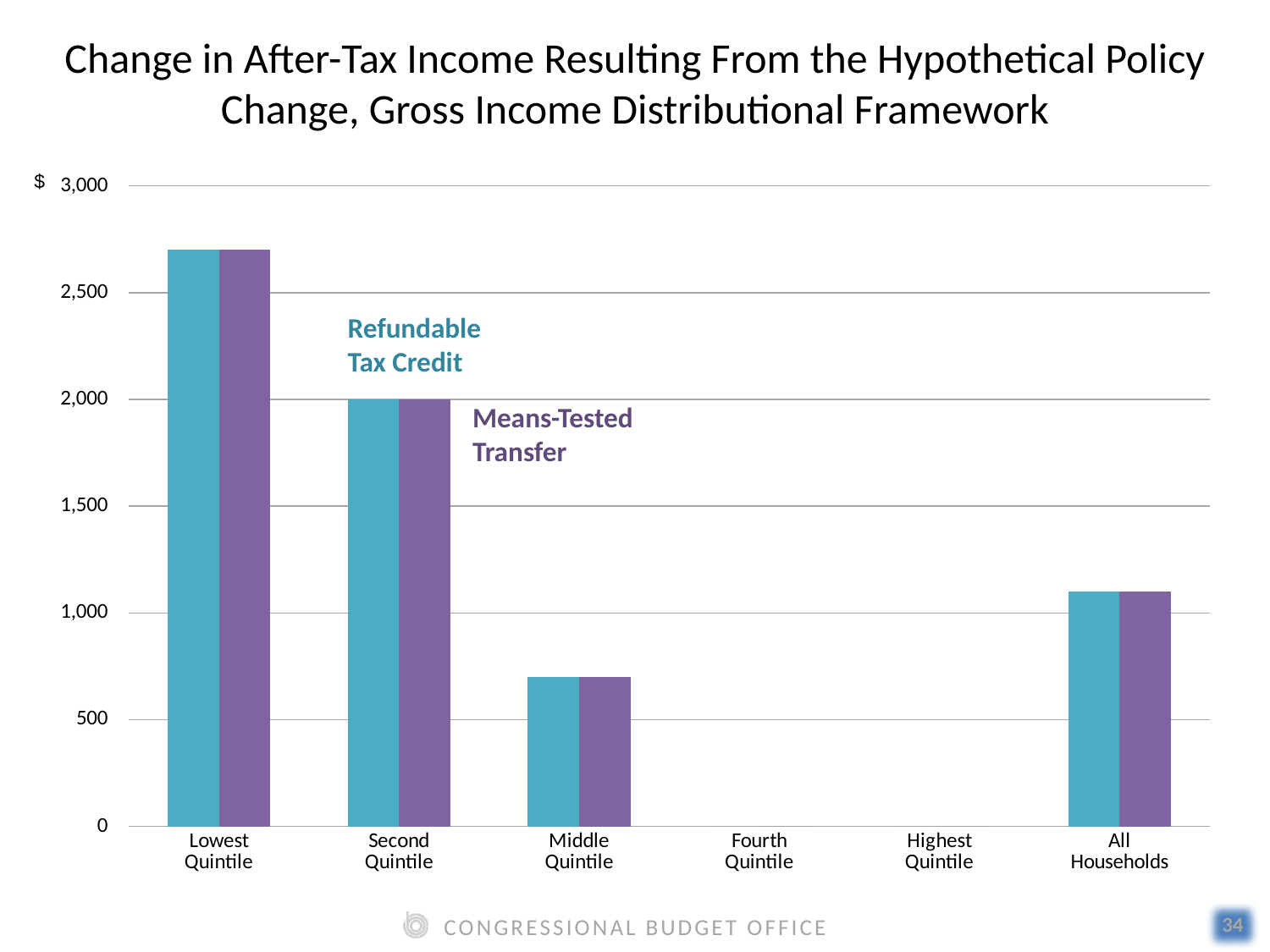
How many series does the chart show? 2 Is the value for the Means-Tested Transfer in the Middle Quintile greater or less than 1,000? less What kind of chart is shown on the slide? bar chart Do the values fall or rise from the Lowest Quintile to the Highest Quintile? fall Which is larger: the Means-Tested Transfer value for the Second Quintile or for All Households? Second Quintile Which category has the highest value for the Refundable Tax Credit? Lowest Quintile Is the value for the Refundable Tax Credit for All Households greater or less than 1,000? greater How many categories are shown on the x axis? 6 Which series is shown in purple? Means-Tested Transfer Is the value for the Refundable Tax Credit in the Lowest Quintile greater or less than 2,500? greater What is the value for the Means-Tested Transfer in the Fourth Quintile? 0 What is the value for the Refundable Tax Credit in the Second Quintile? 2,000